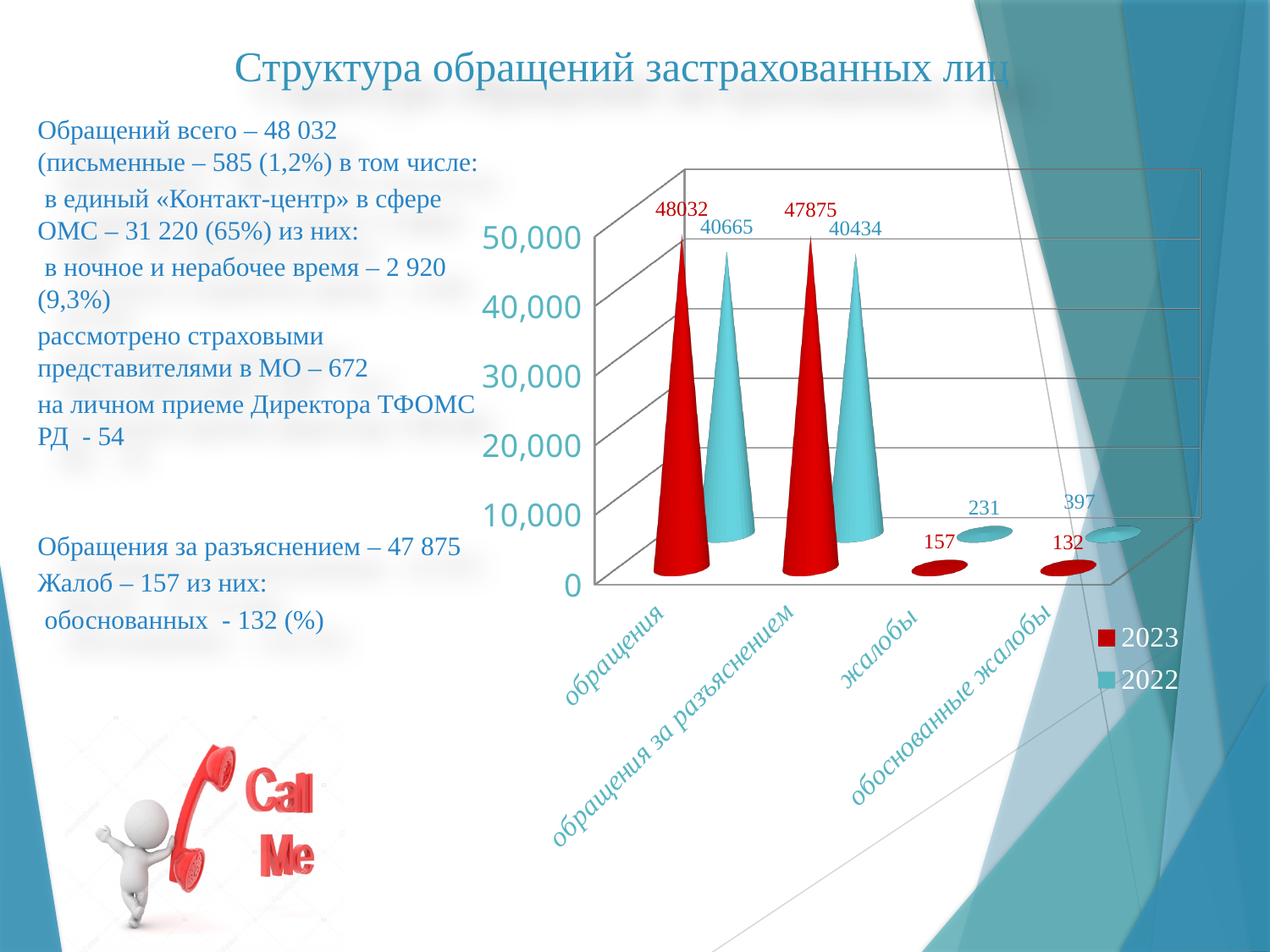
What is the value for 2023 in the обращения category? 48032 What is the value for 2023 in the жалобы category? 157 Which category has the lowest value for the 2023 series? обоснованные жалобы How many series does the chart legend list? 2 What kind of chart is shown on the slide? bar chart Which category has the highest value for the 2023 series? обращения Which colour represents the 2022 series in the chart? light blue How many categories are shown on the x axis of the chart? 4 In the обоснованные жалобы category, which series has the larger value, 2023 or 2022? 2022 What is the value for 2022 in the обоснованные жалобы category? 397 What is the value for 2022 in the обращения за разъяснением category? 40434 What is the difference between the 2023 and 2022 values in the обращения category? 7367